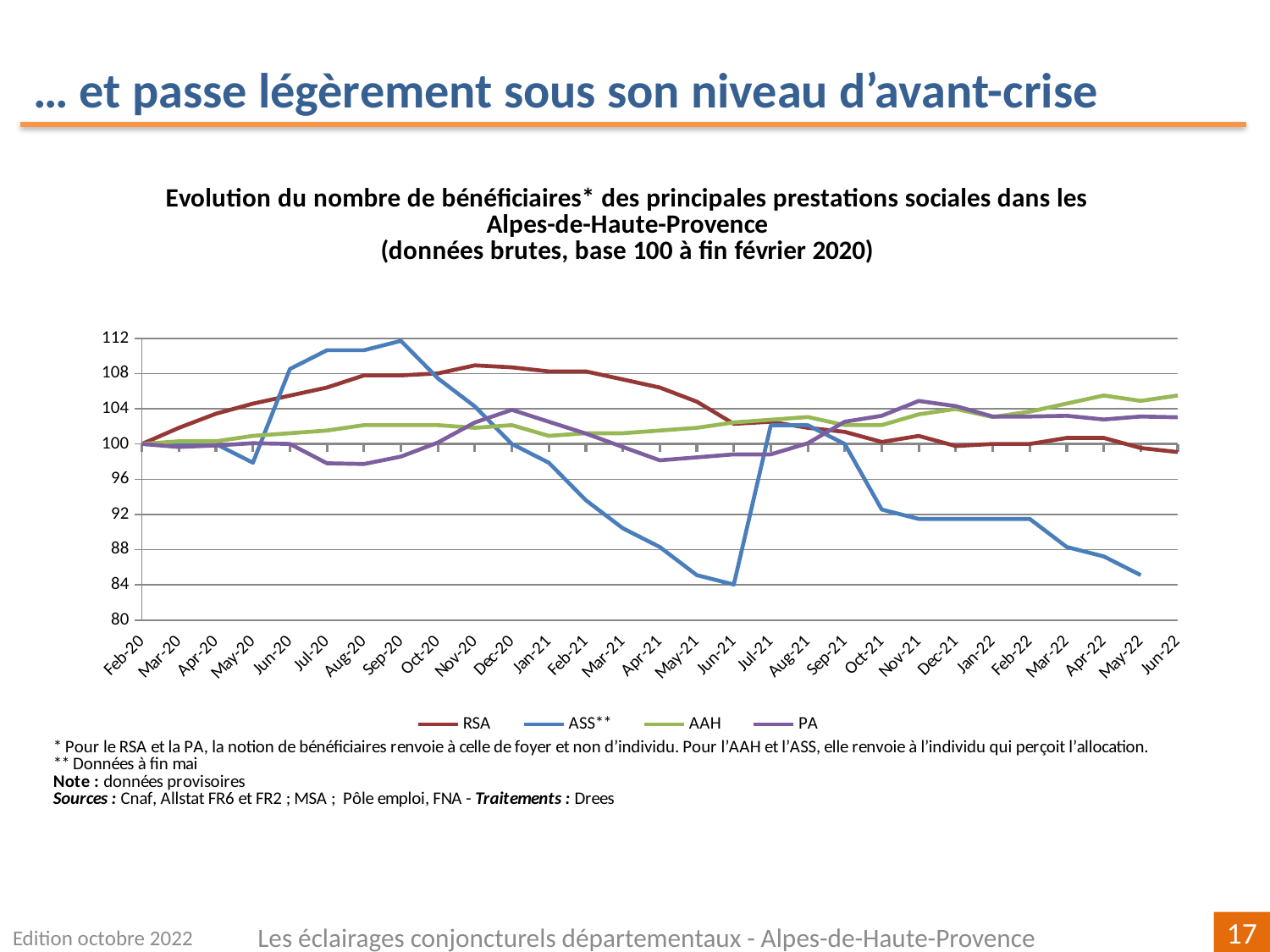
How many monthly points are plotted along the x axis, from Feb-20 to Jun-22? 29 Which series has the lowest value in Jun-21? ASS** In Jun-21, which is larger, the value for RSA or the value for ASS**? RSA Is the value for AAH in Apr-22 greater or less than 104? greater What kind of chart is shown on the slide? line chart Which series has the highest value in Sep-20? ASS** Does the ASS** line rise or fall between Sep-20 and Jun-21? fall Is the value for ASS** in Jun-21 greater or less than 88? less Is the value for ASS** in Sep-20 greater or less than 108? greater How many series does the legend list? 4